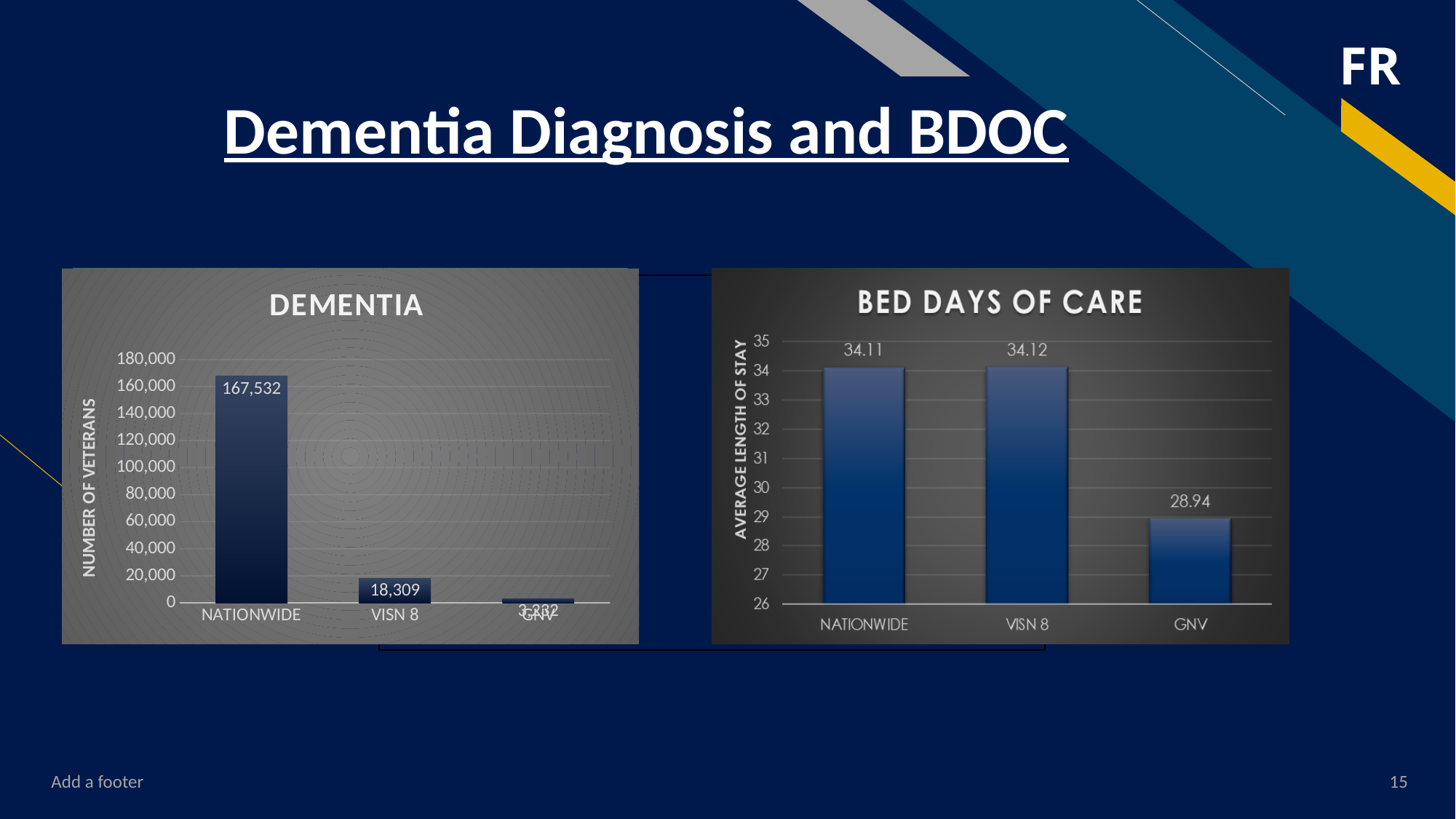
In the DEMENTIA chart, which category has the highest number of veterans? NATIONWIDE In the BED DAYS OF CARE chart, what is the value for GNV? 28.94 In the BED DAYS OF CARE chart, which category has the lowest average length of stay? GNV In the BED DAYS OF CARE chart, what is the value for NATIONWIDE? 34.11 In the DEMENTIA chart, is the value for VISN 8 greater or less than 20,000? less In the DEMENTIA chart, which category has the lowest number of veterans? GNV In the DEMENTIA chart, what is the difference between the NATIONWIDE and VISN 8 values? 149,223 In the BED DAYS OF CARE chart, what is the difference between the VISN 8 and GNV values? 5.18 What type of chart is the DEMENTIA chart? bar chart In the DEMENTIA chart, what is the value for VISN 8? 18,309 How many categories are shown in the BED DAYS OF CARE chart? 3 In the DEMENTIA chart, what is the value for NATIONWIDE? 167,532